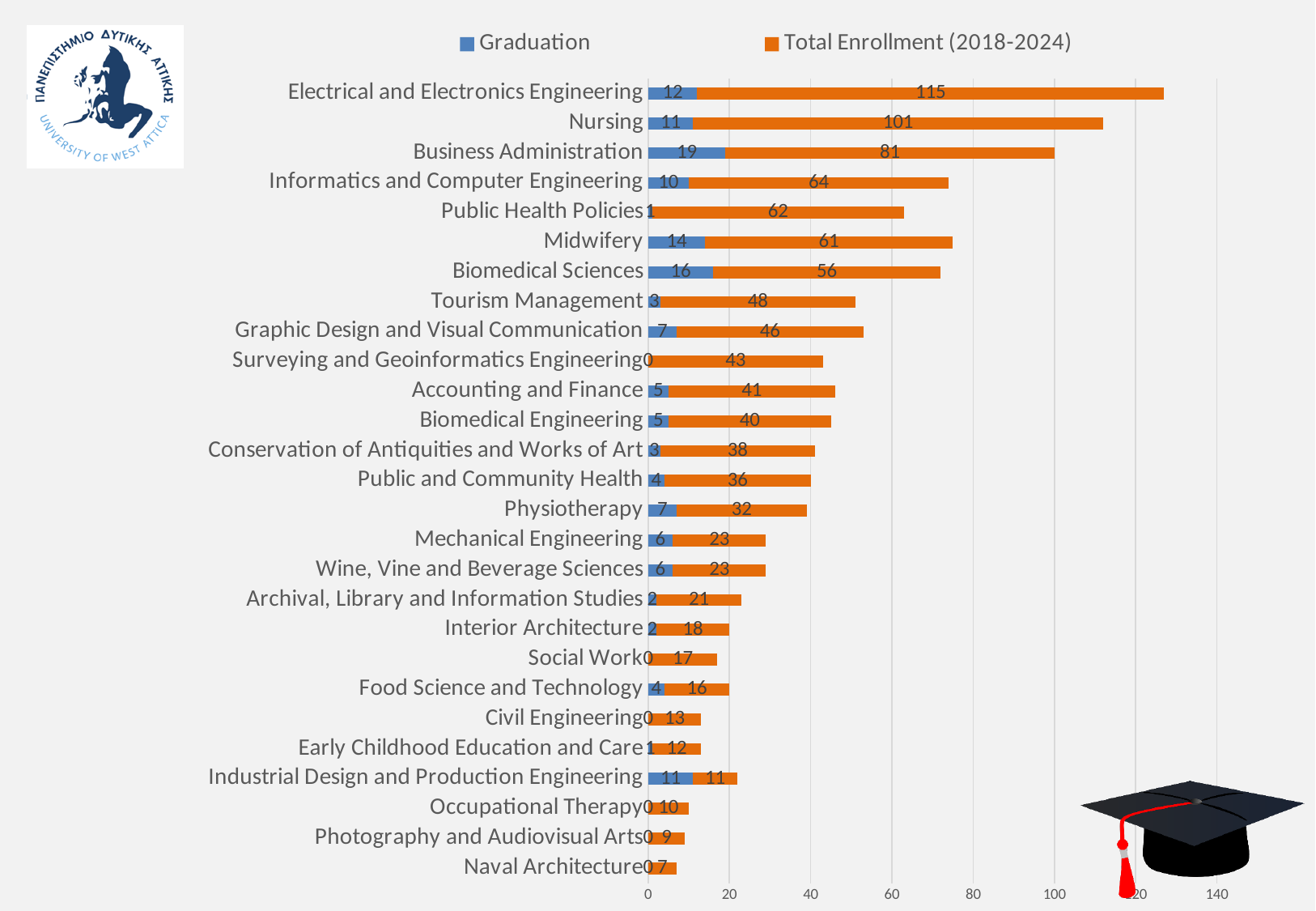
Which department has the highest Graduation value? Business Administration How many departments are listed on the chart? 27 Which department has the highest Total Enrollment (2018-2024)? Electrical and Electronics Engineering How many series does the legend list? 2 What is the combined total of Graduation and Total Enrollment (2018-2024) for Electrical and Electronics Engineering? 127 What is the Graduation value for Midwifery? 14 What is the Graduation value for Business Administration? 19 What is the difference in Total Enrollment (2018-2024) between Electrical and Electronics Engineering and Nursing? 14 What kind of chart is shown on the slide? Bar chart Which has a larger Total Enrollment (2018-2024), Midwifery or Biomedical Sciences? Midwifery Which department has the lowest Total Enrollment (2018-2024)? Naval Architecture What is the Total Enrollment (2018-2024) value for Nursing? 101